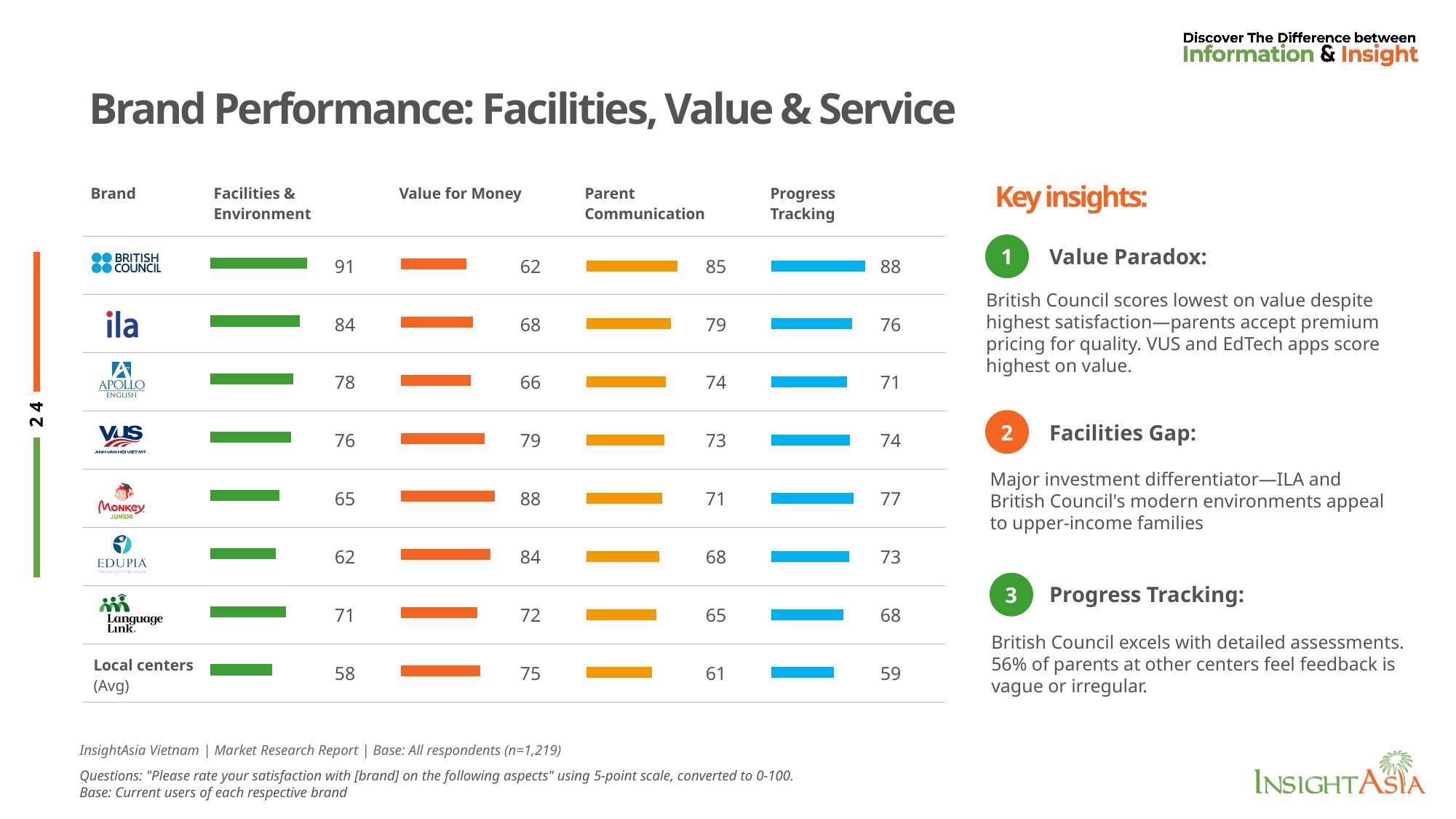
Which is higher: VUS's Value for Money score or ILA's Value for Money score? VUS What colour are the bars in the Progress Tracking column? Blue What is the difference between British Council's Facilities & Environment score and its Value for Money score? 29 How many rating aspects (columns with bars) are shown in the table? 4 What is the Facilities & Environment score for British Council? 91 Which brand has the lowest Facilities & Environment score? Local centers (Avg) What is the Progress Tracking score for Local centers (Avg)? 59 Which brand has the highest Value for Money score? Monkey Junior What is the Parent Communication score for Language Link? 65 What is the Value for Money score for Monkey Junior? 88 How many brands (rows) are shown in the table? 8 Which brand has the highest Progress Tracking score? British Council